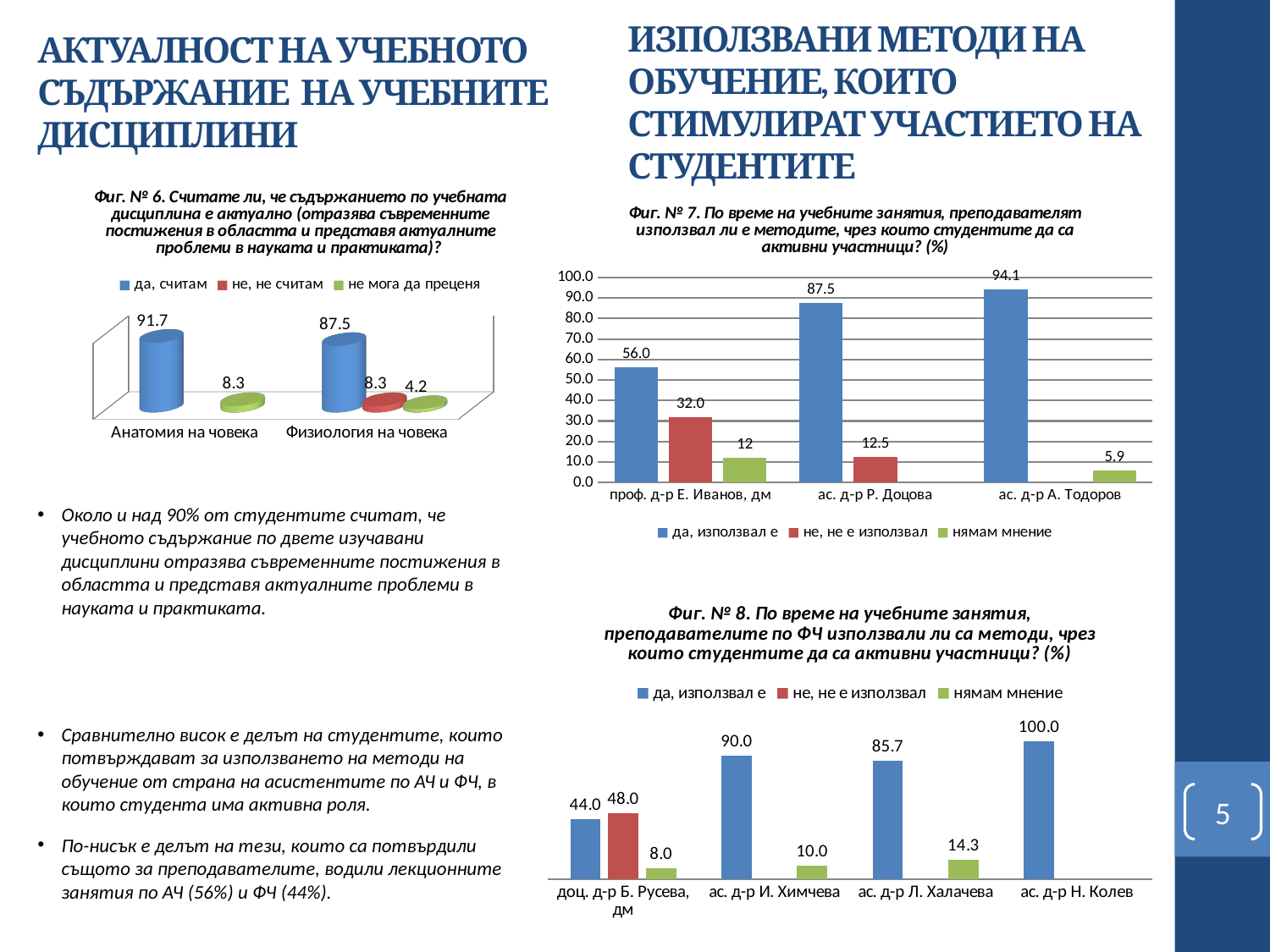
In the chart for Фиг. № 6, what is the value of "да, считам" for Физиология на човека? 87.5 In the chart for Фиг. № 7, what is the value of "да, използвал е" for проф. д-р Е. Иванов, дм? 56.0 In the chart for Фиг. № 7, which lecturer has the highest value for "да, използвал е"? ас. д-р А. Тодоров In the chart for Фиг. № 8, what is the value of "да, използвал е" for ас. д-р Н. Колев? 100.0 In the chart for Фиг. № 7, what is the value of "нямам мнение" for ас. д-р А. Тодоров? 5.9 In the chart for Фиг. № 7, what is the difference between the "да, използвал е" and "не, не е използвал" values for проф. д-р Е. Иванов, дм? 24.0 In the chart for Фиг. № 8, which lecturer has the lowest value for "да, използвал е"? доц. д-р Б. Русева, дм In the chart for Фиг. № 8, how many series does the legend list? 3 In the chart for Фиг. № 6, what is the difference between the "да, считам" values for Анатомия на човека and Физиология на човека? 4.2 In the chart for Фиг. № 8, which is larger for доц. д-р Б. Русева, дм: "да, използвал е" or "не, не е използвал"? не, не е използвал In the chart for Фиг. № 7, how many lecturers are shown on the x axis? 3 What kind of chart is used for Фиг. № 8? bar chart